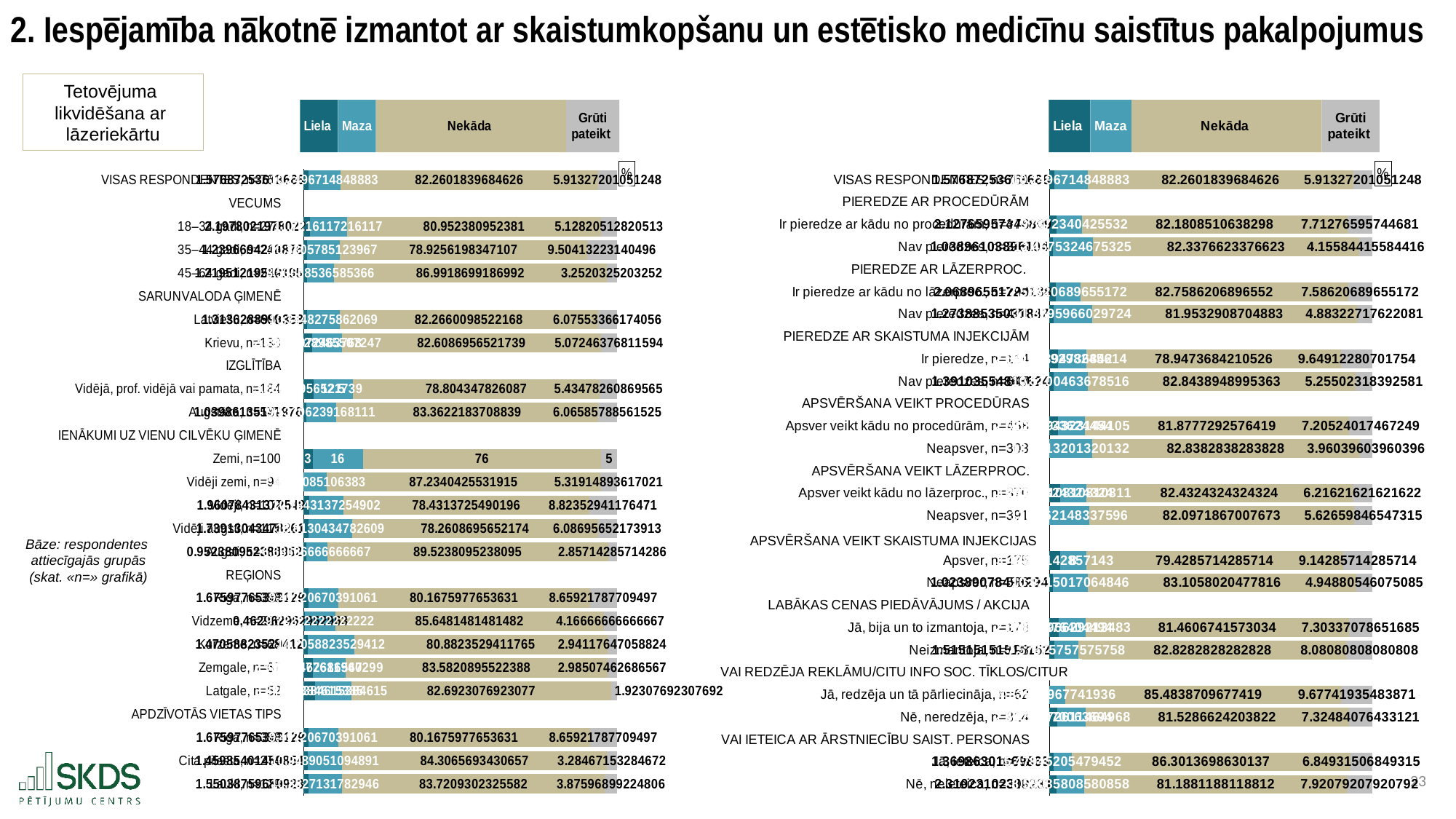
In the left chart, what is the total of the stacked bar for 'Zemi, n=100'? 100 In the right chart, which has the larger 'Nekāda' value: 'Neapsver, n=303' or 'Neapsver, n=391'? Neapsver, n=303 In the right chart, what is the 'Grūti pateikt' value for 'Neapsver, n=303'? 3.96039603960396 In the left chart, what is the 'Grūti pateikt' value for 'VISAS RESPONDENTES'? 5.91327201051248 Which legend entry is shown in the beige/tan colour in the charts? Nekāda In the left chart, what is the 'Maza' value for the category 'Zemi, n=100'? 16 How many series does the legend list for the charts on this slide? 4 In the left chart, what is the 'Liela' value for the category 'Zemi, n=100'? 3 In the right chart, what is the 'Nekāda' value for 'Neapsver, n=303'? 82.8382838283828 What kind of chart is shown on the left side of the slide? Stacked bar chart In the left chart, what is the 'Nekāda' value for the category 'Krievu'? 82.6086956521739 In the left chart, what is the 'Nekāda' value for the category 'Zemi, n=100'? 76